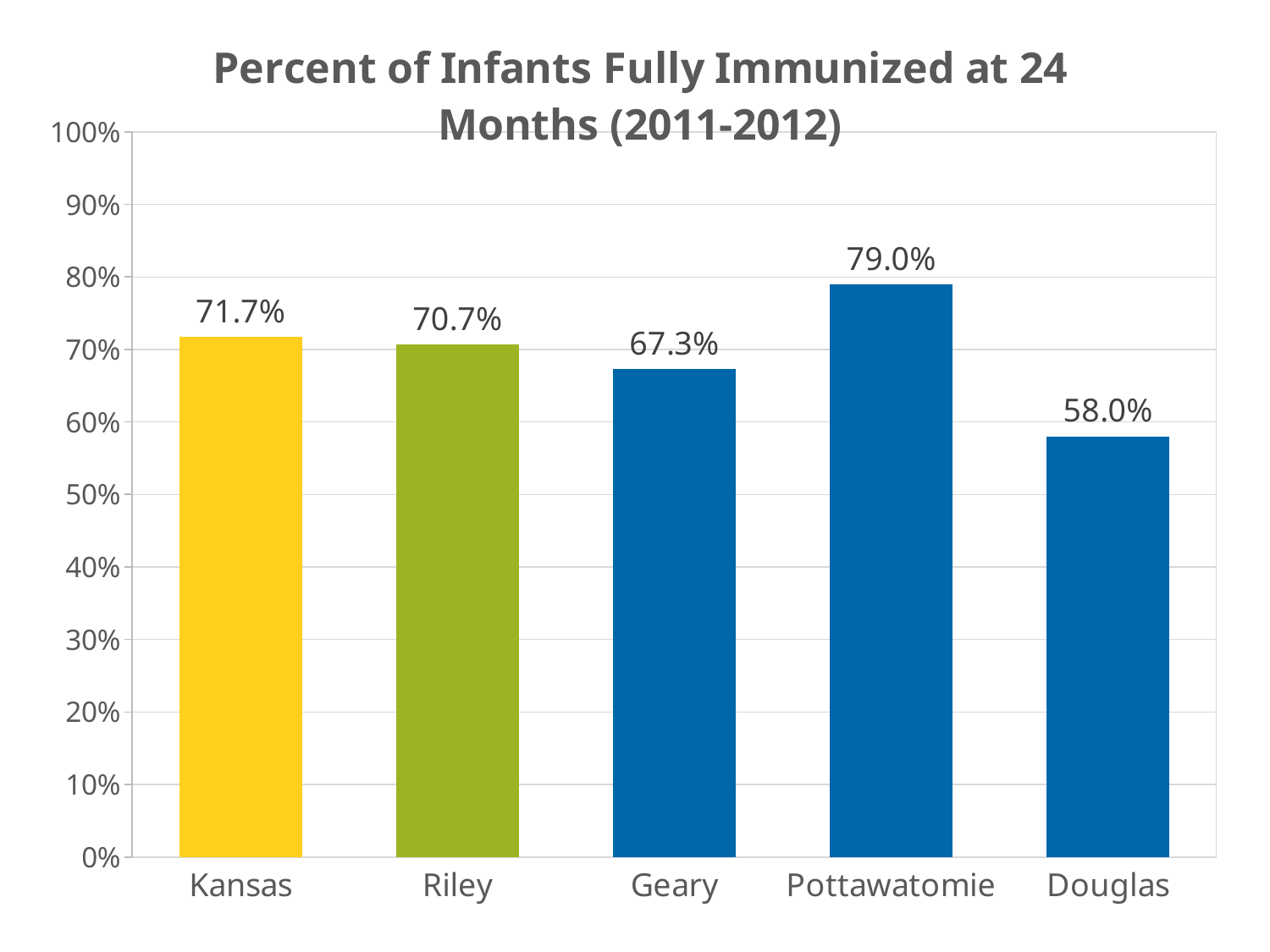
What is the title of the chart? Percent of Infants Fully Immunized at 24 Months (2011-2012) What is the value shown for Riley? 70.7% How many categories are shown on the x axis? 5 Which has a higher value, Geary or Pottawatomie? Pottawatomie What is the difference between the values for Kansas and Geary? 4.4% Which category has the lowest percent of infants fully immunized? Douglas What is the difference between the values for Pottawatomie and Douglas? 21.0% Is the value for Douglas greater or less than 60%? less What is the value shown for Douglas? 58.0% What kind of chart is shown on the slide? bar chart What is the percent of infants fully immunized at 24 months for Kansas? 71.7% Which category has the highest percent of infants fully immunized? Pottawatomie